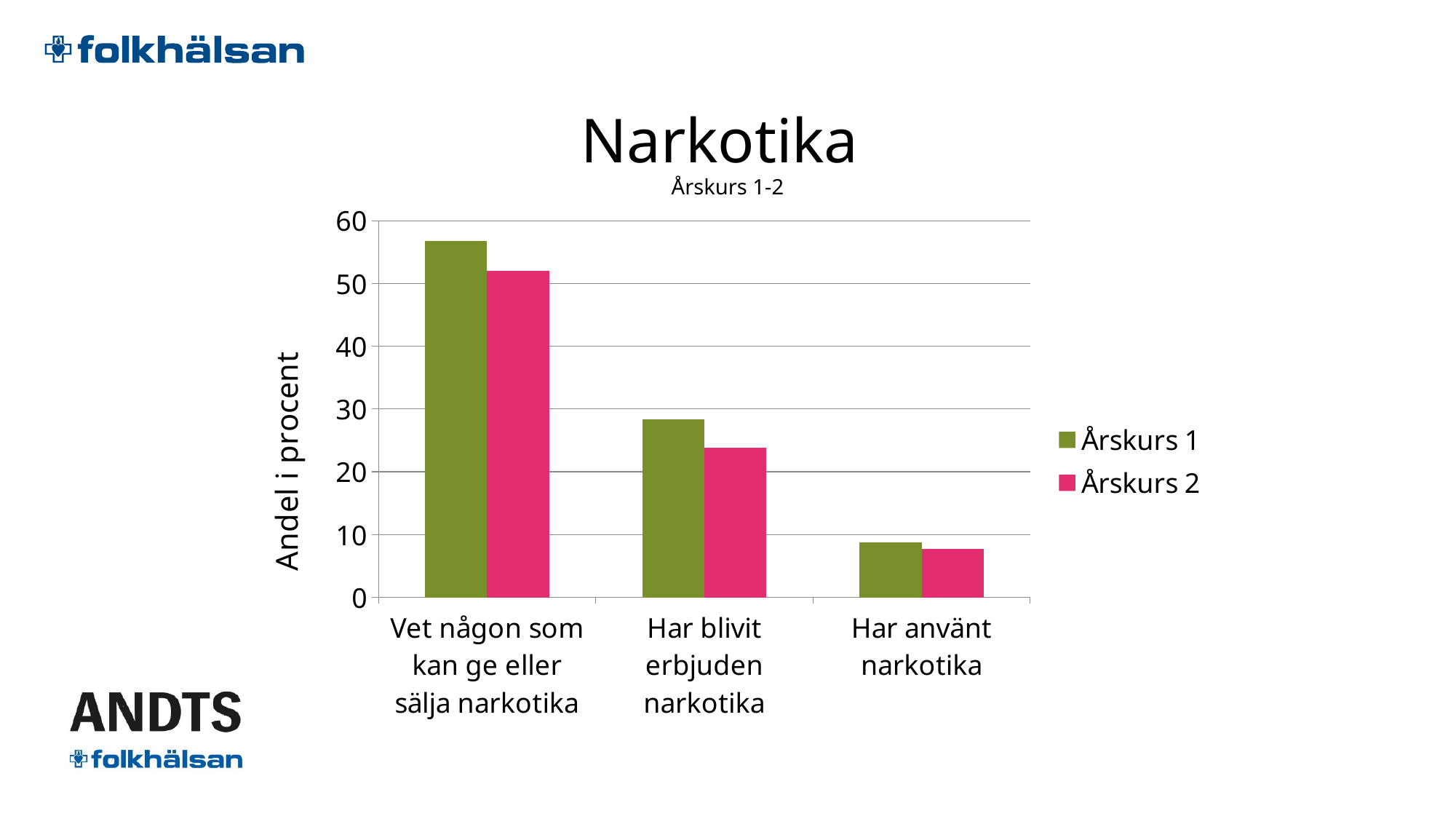
Which category has the highest value for Årskurs 1? Vet någon som kan ge eller sälja narkotika How many series does the legend list? 2 Which category has the lowest value for Årskurs 2? Har använt narkotika Is the value for Årskurs 2 in 'Vet någon som kan ge eller sälja narkotika' greater or less than 40? greater What is the label of the y axis? Andel i procent For 'Har blivit erbjuden narkotika', which series has the larger value, Årskurs 1 or Årskurs 2? Årskurs 1 Do the values for Årskurs 1 rise or fall from left to right along the x axis? fall What kind of chart is shown on the slide? bar chart Is the value for Årskurs 1 in 'Vet någon som kan ge eller sälja narkotika' greater or less than 50? greater Is the value for Årskurs 2 in 'Har blivit erbjuden narkotika' greater or less than 30? less How many categories are shown on the x axis? 3